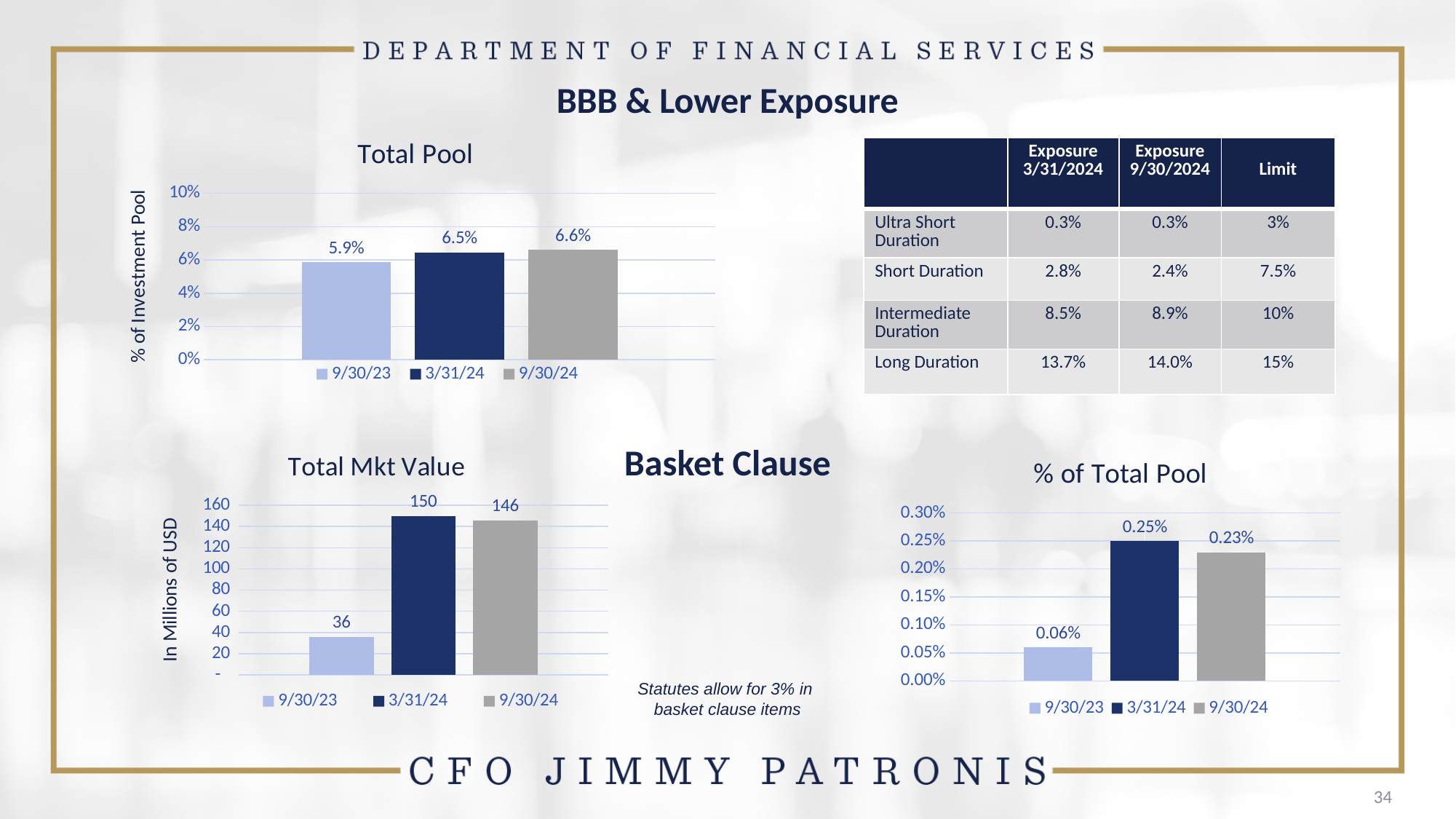
In the Total Pool chart, which date has the highest value? 9/30/24 In the Total Pool chart, what is the difference between the 9/30/24 and 9/30/23 values? 0.7% In the Total Mkt Value chart, which date has the lowest value? 9/30/23 What is the y-axis label of the Total Mkt Value chart? In Millions of USD In the Total Mkt Value chart, what is the difference between the 3/31/24 and 9/30/24 values? 4 In the % of Total Pool chart, which is larger, the value for 3/31/24 or the value for 9/30/24? 3/31/24 In the Total Pool chart, what is the value for 9/30/23? 5.9% What kind of chart is the % of Total Pool chart? bar chart In the Total Pool chart, is the value for 3/31/24 greater or less than 4%? greater In the % of Total Pool chart, what is the value for 9/30/23? 0.06% In the Total Mkt Value chart, what is the value for 3/31/24? 150 In the Total Mkt Value chart, how many series does the legend list? 3